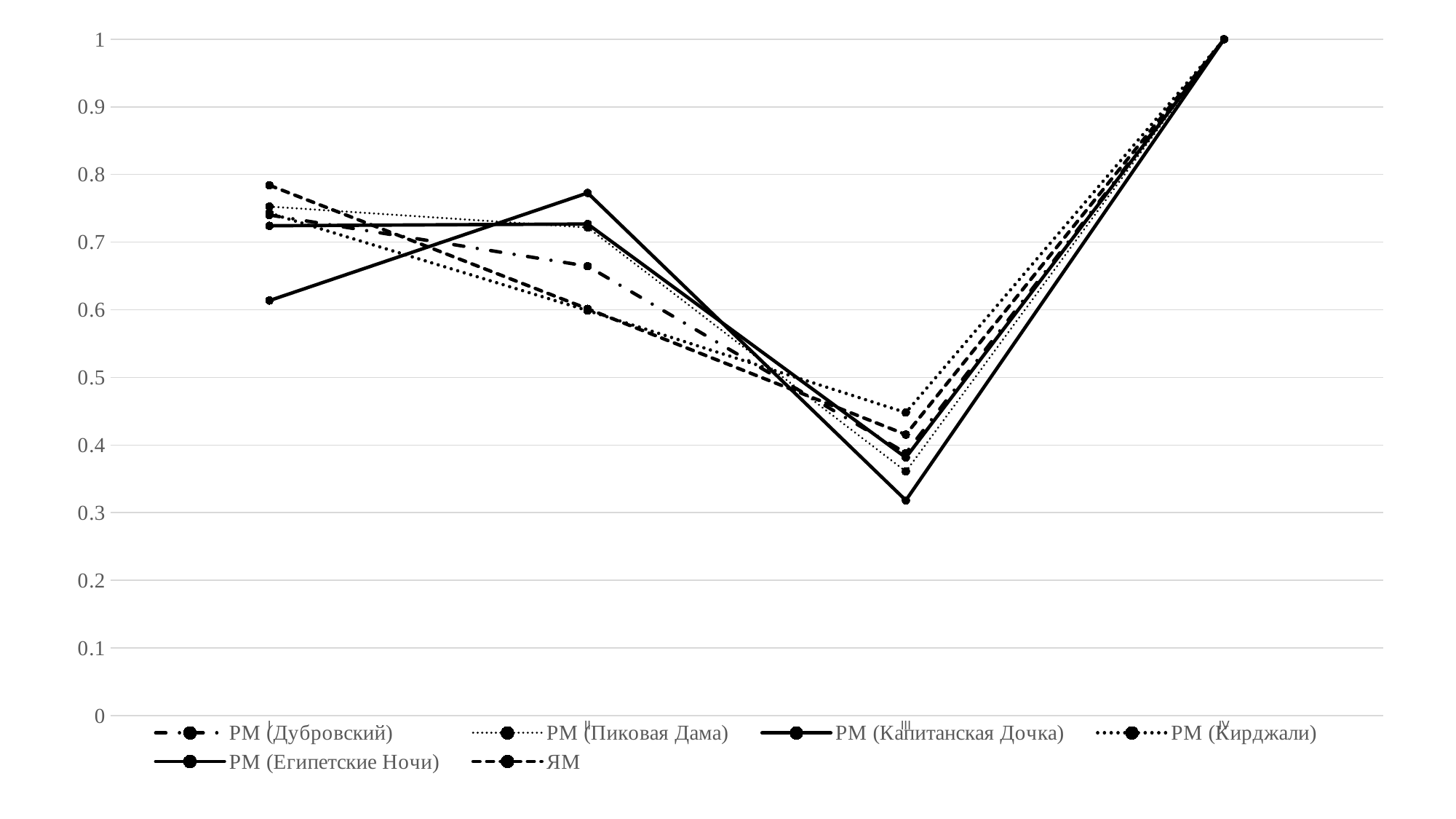
What kind of chart is shown on the slide? line chart At which x-axis point do all the series reach their highest values? IV Is the highest value at point I greater or less than 0.7? greater Is the highest value at point III greater or less than 0.5? less What value do all the series reach at the last point (IV)? 1 Do the values rise or fall from point III to point IV? rise Is the lowest value at point III greater or less than 0.4? less What is the maximum value shown on the y axis? 1 What is the name of the last legend entry? ЯМ How many series does the legend list? 6 At which x-axis point do all the series reach their lowest values? III How many points does each series have along the x axis? 4